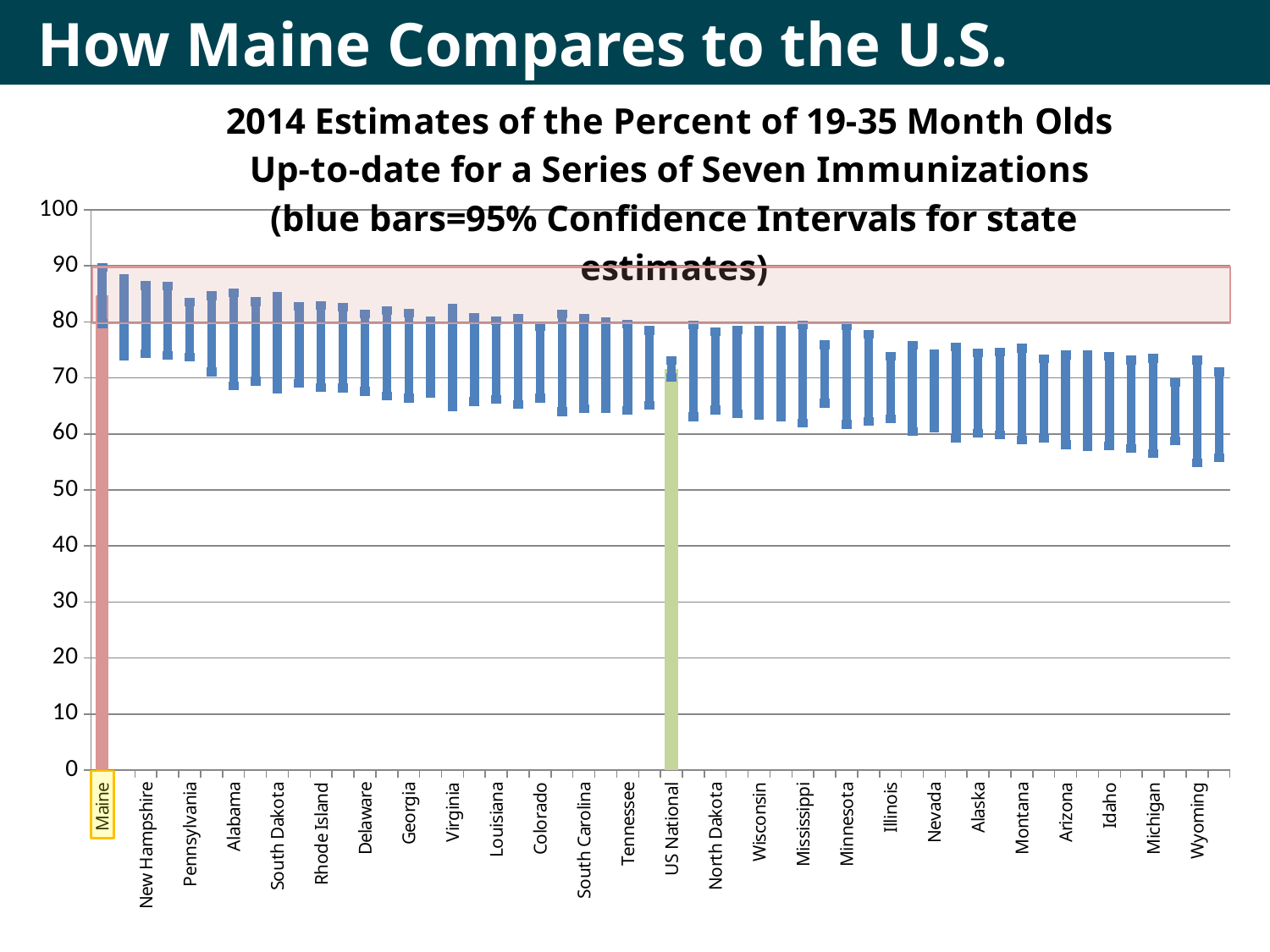
Is the bottom of the confidence interval bar for New Hampshire greater or less than 70? greater Is the top of the confidence interval bar for Maine greater or less than 80? greater Which category is highlighted with a green bar? US National What is the title of the chart? 2014 Estimates of the Percent of 19-35 Month Olds Up-to-date for a Series of Seven Immunizations (blue bars=95% Confidence Intervals for state estimates) What kind of chart is shown on the slide? bar chart Does the confidence interval bar for Maine reach higher than the bar for Wyoming? Yes Is the bottom of the confidence interval bar for Wyoming greater or less than 60? less Do the confidence interval bars generally rise or fall from left to right along the x axis? fall Which labelled state has the confidence interval bar that reaches highest on the chart? Maine What is the maximum value shown on the vertical axis? 100